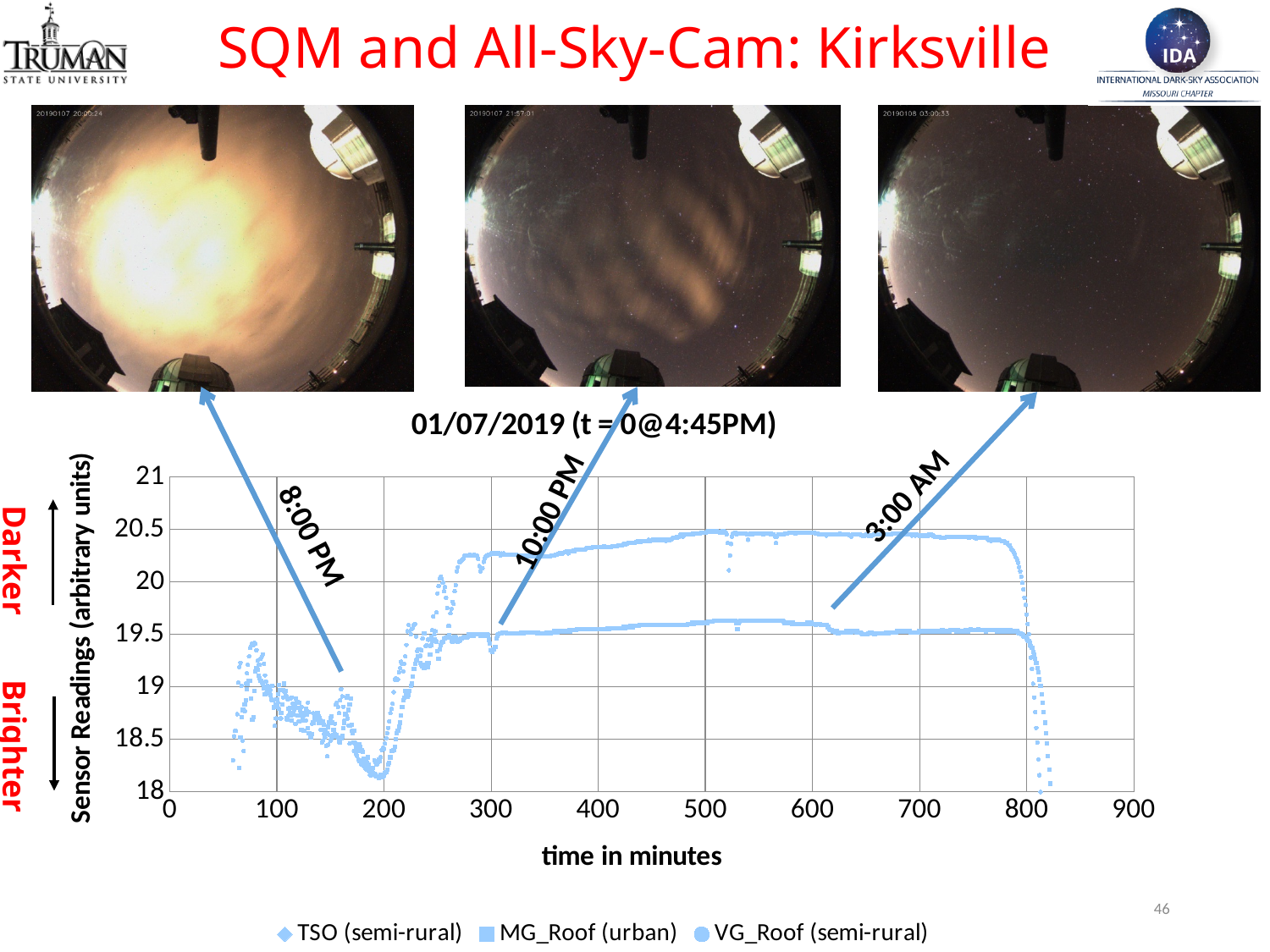
What kind of chart is shown on the slide? scatter chart What is the title of the chart? 01/07/2019 (t = 0@4:45PM) What is the label of the x axis of the chart? time in minutes Between 200 and 500 minutes, do the sensor readings rise or fall? rise Is the value of the lower curve at 700 minutes greater or less than 20? less At 500 minutes, which curve has the larger value, the upper curve or the lower curve? the upper curve Around 800 minutes, do the sensor readings rise or fall? fall What is the highest value shown on the y axis of the chart? 21 Is the value of the upper curve at 500 minutes greater or less than 20? greater Is the value of the upper curve at 300 minutes greater or less than 19.5? greater How many series does the chart legend list? 3